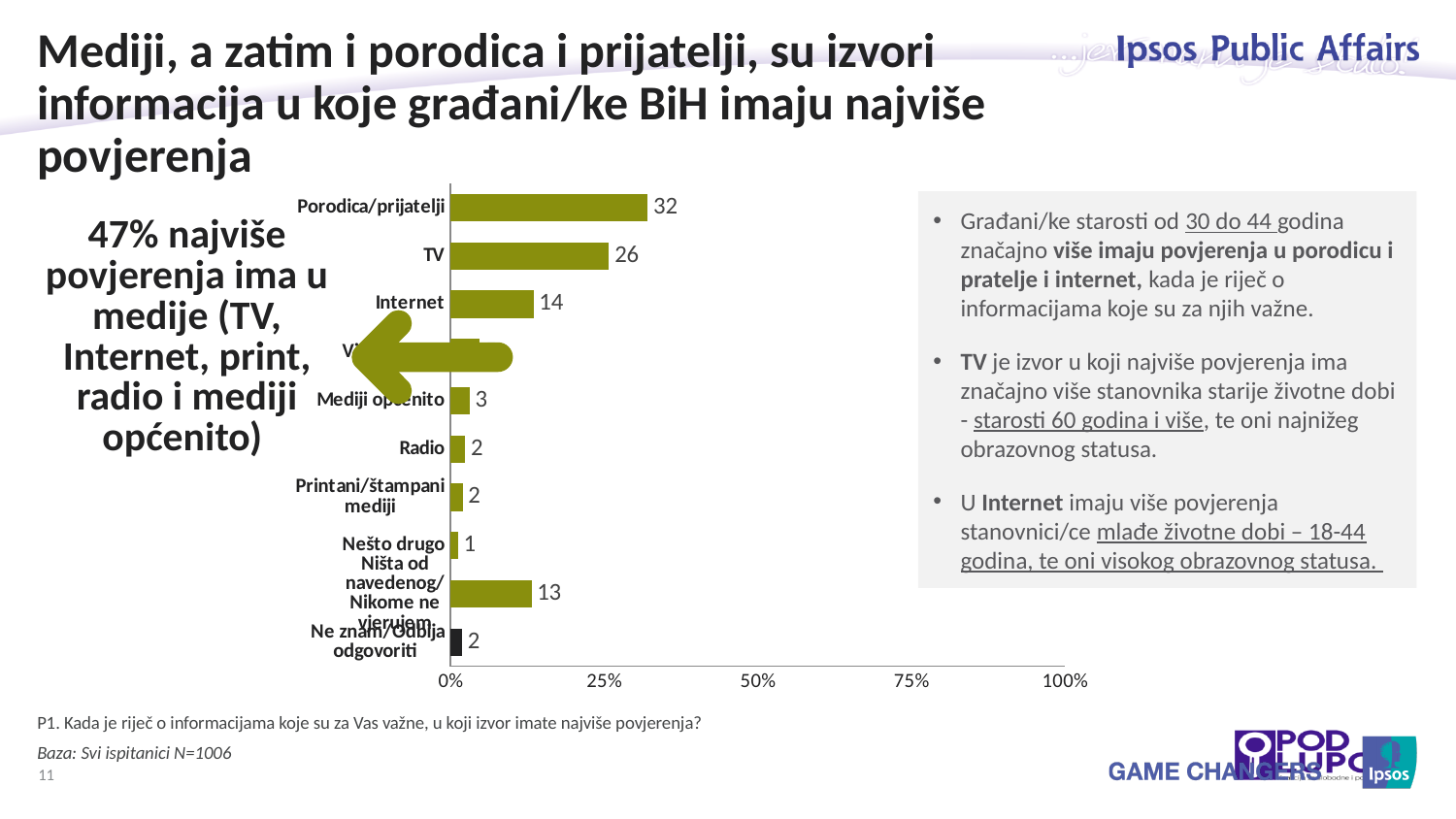
What value is shown for Porodica/prijatelji? 32 Which category has the highest value? Porodica/prijatelji What is the highest value shown on the x axis? 100% What value is shown for Ništa od navedenog/Nikome ne vjerujem? 13 What value is shown for Internet? 14 What is the difference between the values for Porodica/prijatelji and TV? 6 Which is larger, the value for TV or the value for Internet? TV What value is shown for Mediji općenito? 3 What kind of chart is shown on the slide? bar chart What value is shown for TV? 26 Which category has the lowest value? Nešto drugo Is the value for Porodica/prijatelji greater or less than 25%? greater